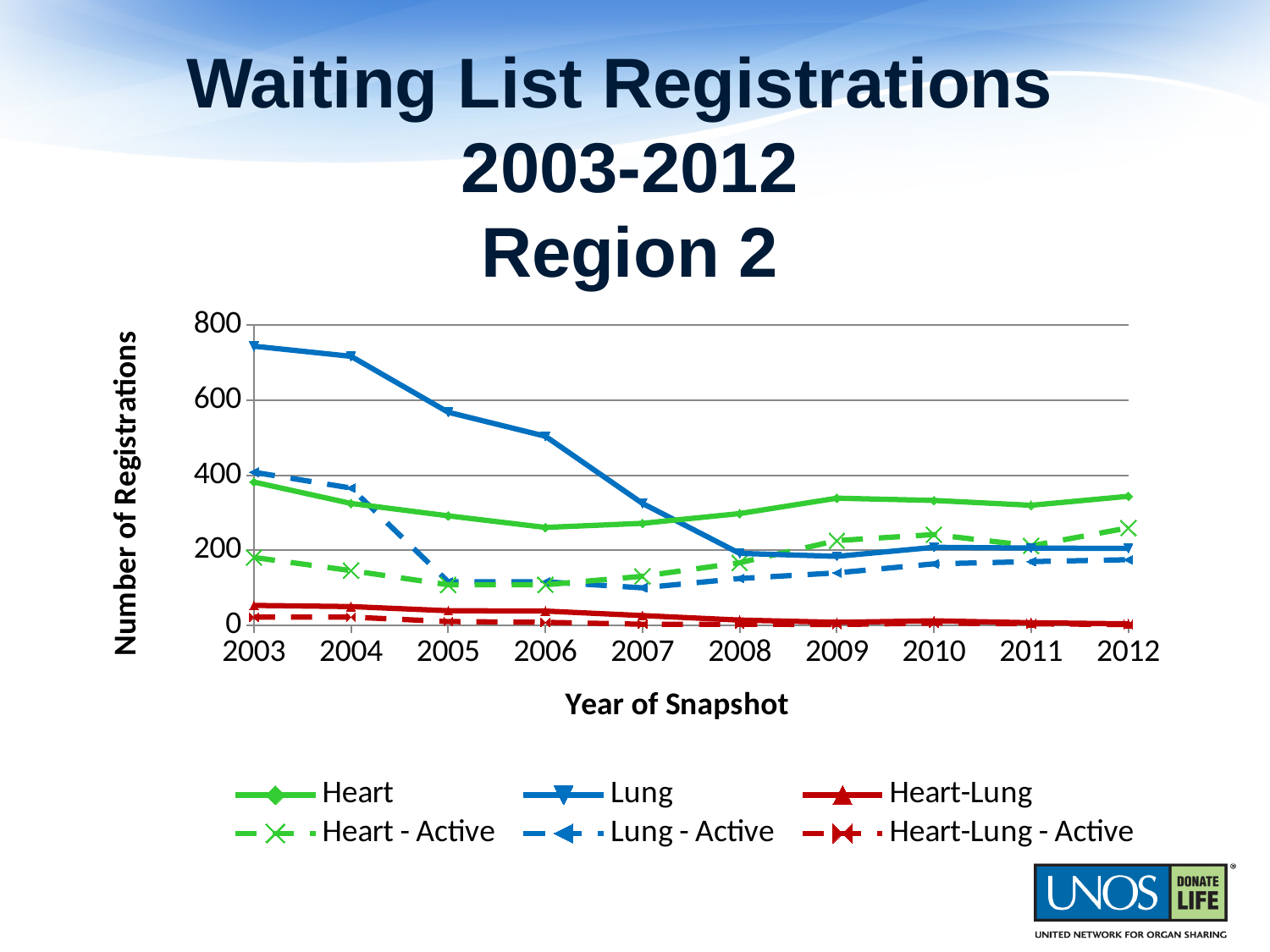
Is the value for Heart in 2003 greater or less than 400? less Does the Lung series rise or fall from 2003 to 2012? fall Is the value for Lung in 2005 greater or less than 400? greater Which series has the highest value in 2003? Lung Is the value for Heart-Lung in 2003 greater or less than 200? less Which is larger in 2012, Heart or Lung? Heart What is the label of the y axis? Number of Registrations In which year is the Lung series at its highest? 2003 What kind of chart is shown on the slide? line chart How many years are plotted along the x axis? 10 How many series does the legend list? 6